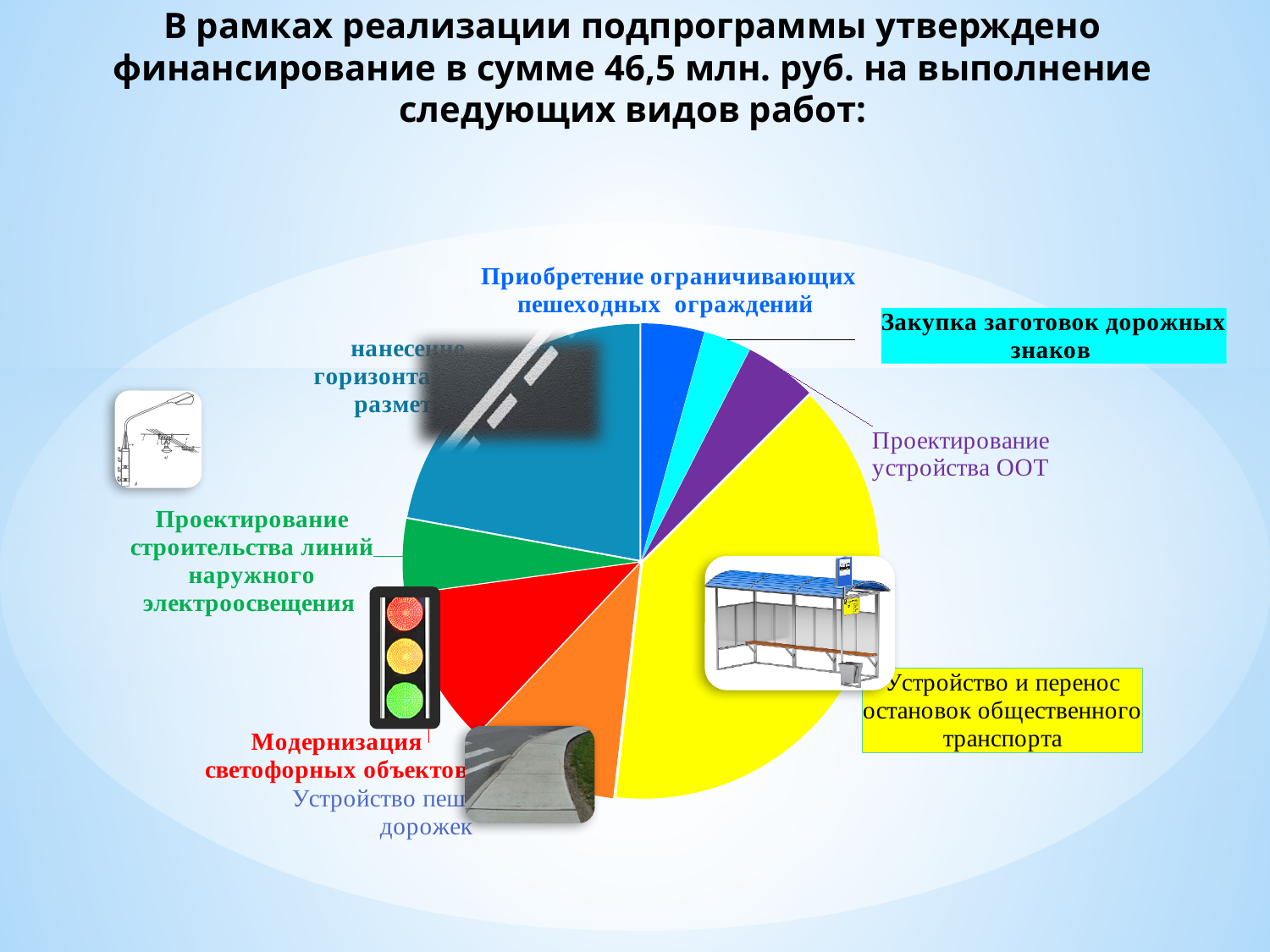
Which slice is larger: Проектирование устройства ООТ or Устройство и перенос остановок общественного транспорта? Устройство и перенос остановок общественного транспорта What colour is the slice for Модернизация светофорных объектов? red Which category has the largest slice of the pie chart? Устройство и перенос остановок общественного транспорта How many slices does the pie chart have? 8 What kind of chart is shown on the slide? pie chart Which slice is larger: Модернизация светофорных объектов or Закупка заготовок дорожных знаков? Модернизация светофорных объектов What colour is the slice for Устройство и перенос остановок общественного транспорта? yellow Which slice is larger: Устройство и перенос остановок общественного транспорта or Проектирование строительства линий наружного электроосвещения? Устройство и перенос остановок общественного транспорта